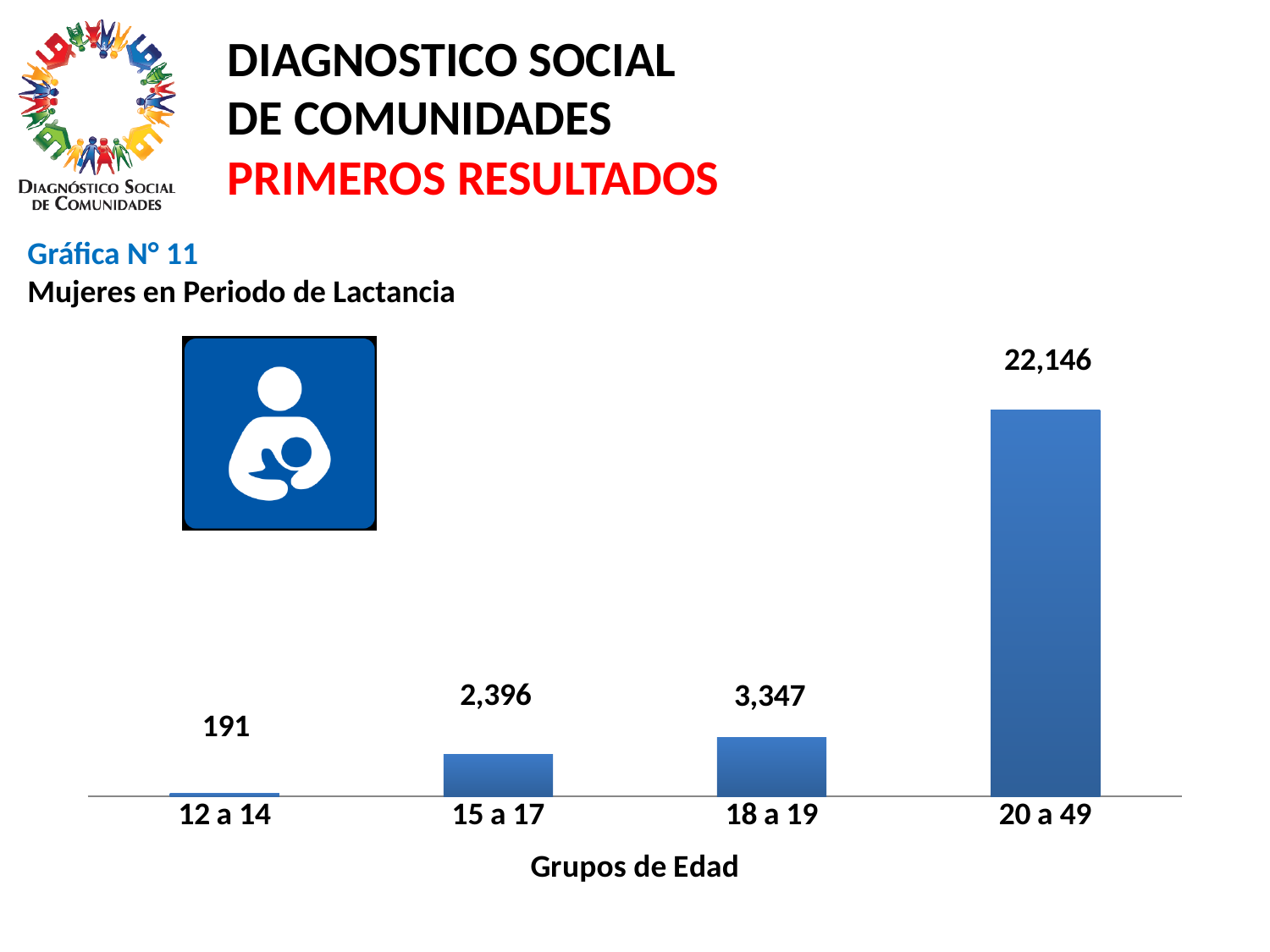
Which is larger, the value for 15 a 17 or the value for 18 a 19? 18 a 19 What is the difference between the values for 18 a 19 and 15 a 17? 951 What is the value for the 18 a 19 age group? 3,347 What is the value for the 12 a 14 age group? 191 What is the value for the 15 a 17 age group? 2,396 Do the values rise or fall from left to right across the age groups? Rise How many age groups are shown in the chart? 4 What is the difference between the values for 20 a 49 and 18 a 19? 18,799 What kind of chart is shown on the slide? Bar chart What is the value for the 20 a 49 age group? 22,146 Which age group has the highest value? 20 a 49 Which age group has the lowest value? 12 a 14